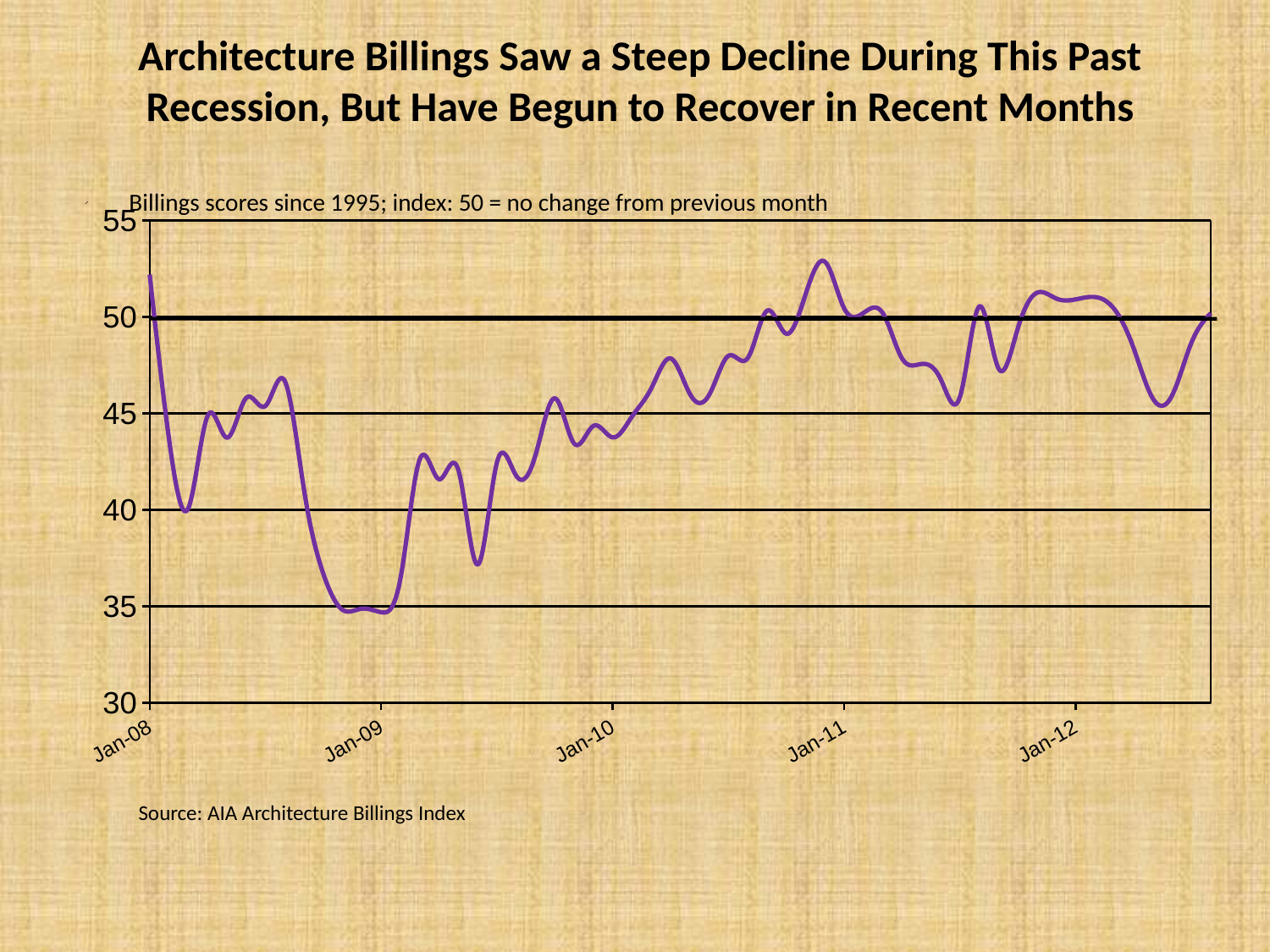
Does the line rise or fall between Jan-08 and Jan-09? fall Is the value at Jan-09 greater or less than 40? less Is the highest point of the line greater or less than 50? greater What kind of chart is shown on the slide? line chart Is the value at Jan-08 greater or less than 50? greater What is the source cited for the chart? AIA Architecture Billings Index How many date labels are shown on the x axis? 5 Does the line rise or fall between Jan-09 and Jan-10? rise According to the chart subtitle, what index value means no change from the previous month? 50